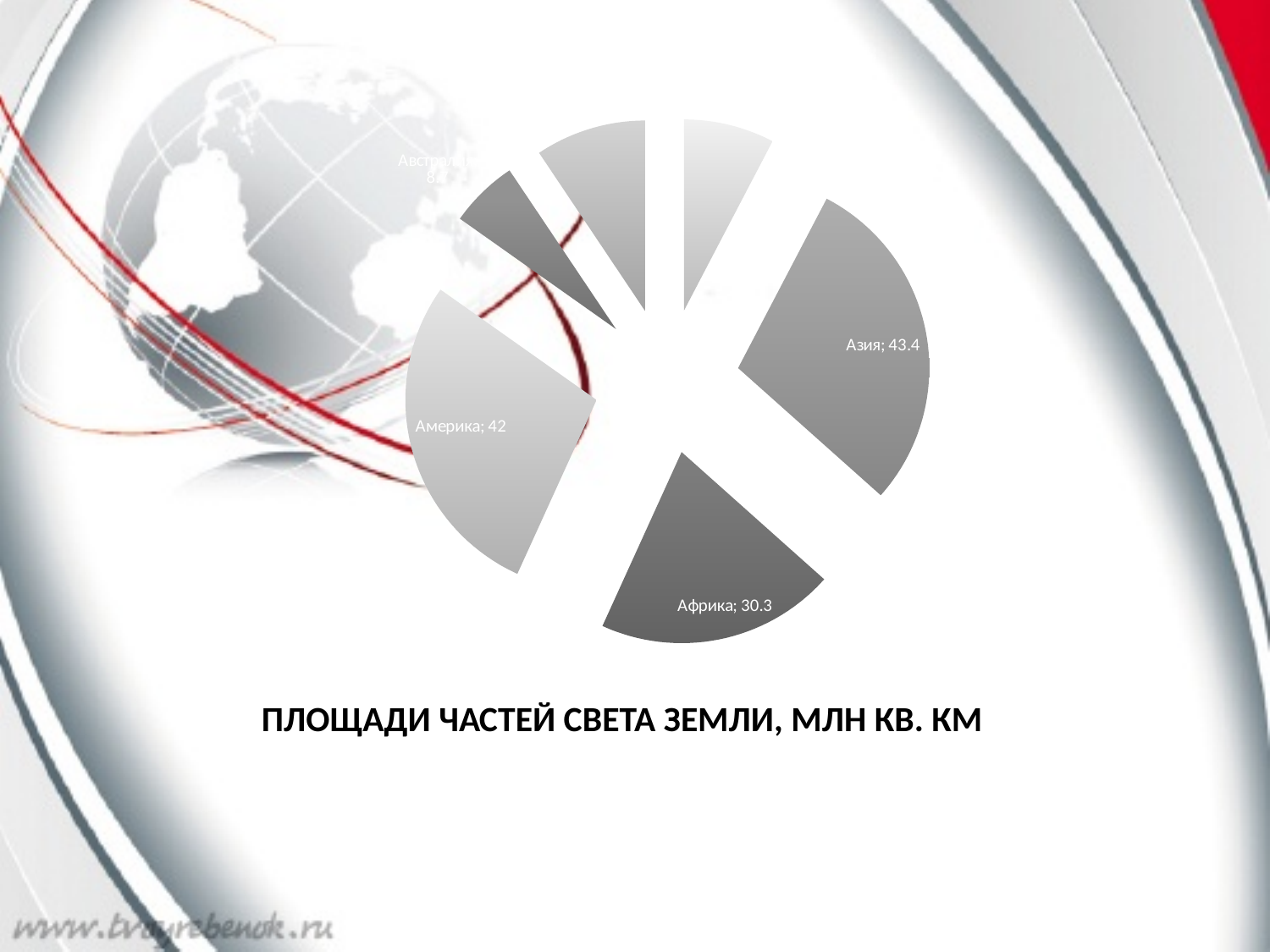
What kind of chart is shown on the slide? Pie chart What is the title of the chart on the slide? ПЛОЩАДИ ЧАСТЕЙ СВЕТА ЗЕМЛИ, МЛН КВ. КМ What is the difference between the values for Азия and Африка? 13.1 What is the value shown for Азия on the pie chart? 43.4 What is the difference between the values for Азия and Америка? 1.4 Which has the larger value on the chart, Америка or Африка? Америка What is the value shown for Америка on the pie chart? 42 What is the difference between the values for Америка and Африка? 11.7 Which has the larger value on the chart, Азия or Америка? Азия Which labelled part of the world has the largest area on the chart? Азия How many slices does the pie chart have? 6 What is the value shown for Африка on the pie chart? 30.3